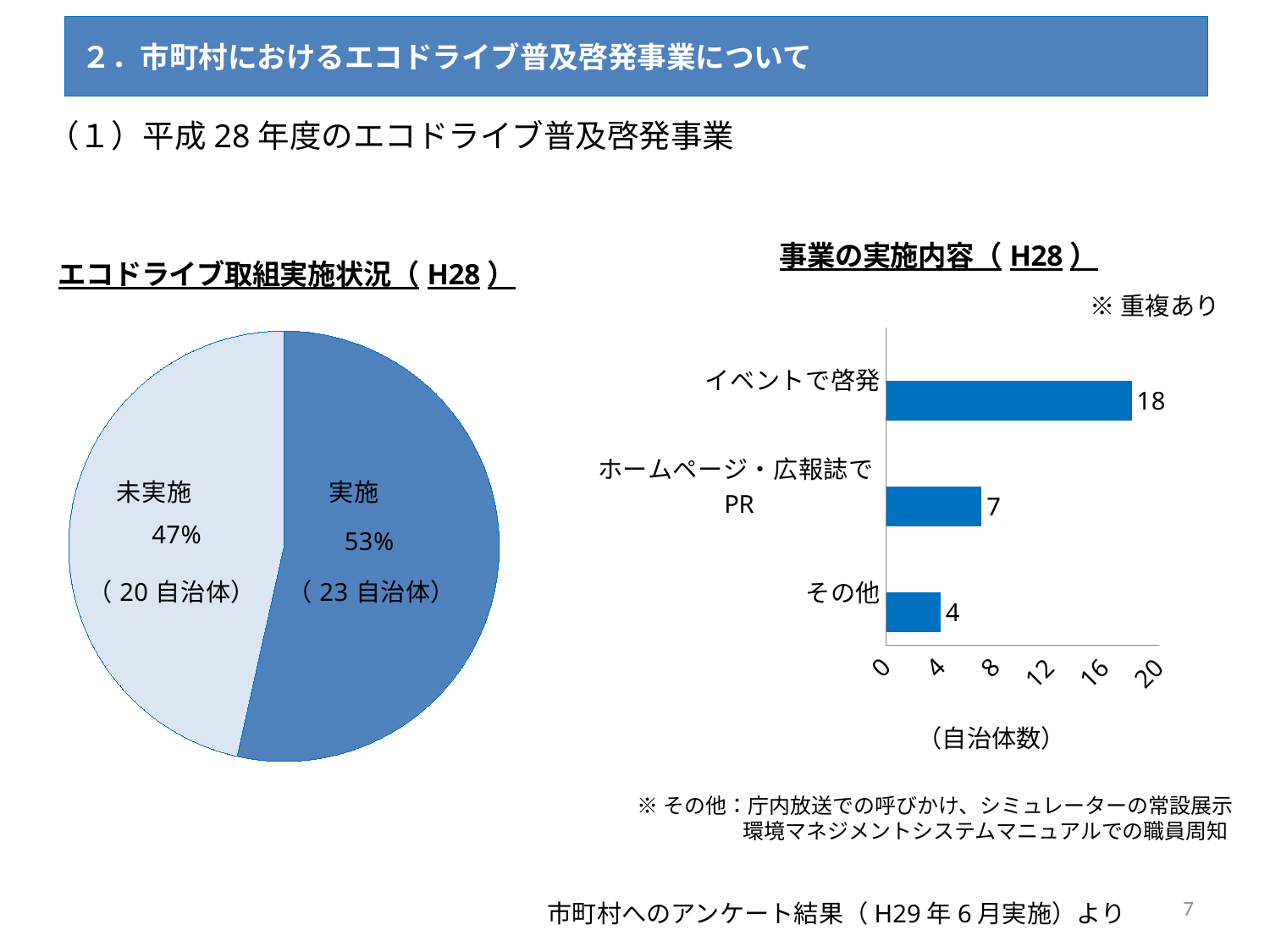
In the pie chart エコドライブ取組実施状況（H28）, what percentage is shown for 未実施? 47% In the pie chart エコドライブ取組実施状況（H28）, what percentage is shown for 実施? 53% In the bar chart 事業の実施内容（H28）, which category has the lowest value? その他 In the pie chart エコドライブ取組実施状況（H28）, how many 自治体 are in the 実施 slice? 23自治体 In the bar chart 事業の実施内容（H28）, what is the value for ホームページ・広報誌でPR? 7 In the pie chart エコドライブ取組実施状況（H28）, how many slices are there? 2 What kind of chart is the chart titled エコドライブ取組実施状況（H28）? pie chart In the bar chart 事業の実施内容（H28）, how many categories are shown? 3 In the bar chart 事業の実施内容（H28）, what is the value for イベントで啓発? 18 What kind of chart is the chart titled 事業の実施内容（H28）? bar chart In the pie chart エコドライブ取組実施状況（H28）, which slice is larger, 実施 or 未実施? 実施 In the bar chart 事業の実施内容（H28）, what is the difference between イベントで啓発 and その他? 14